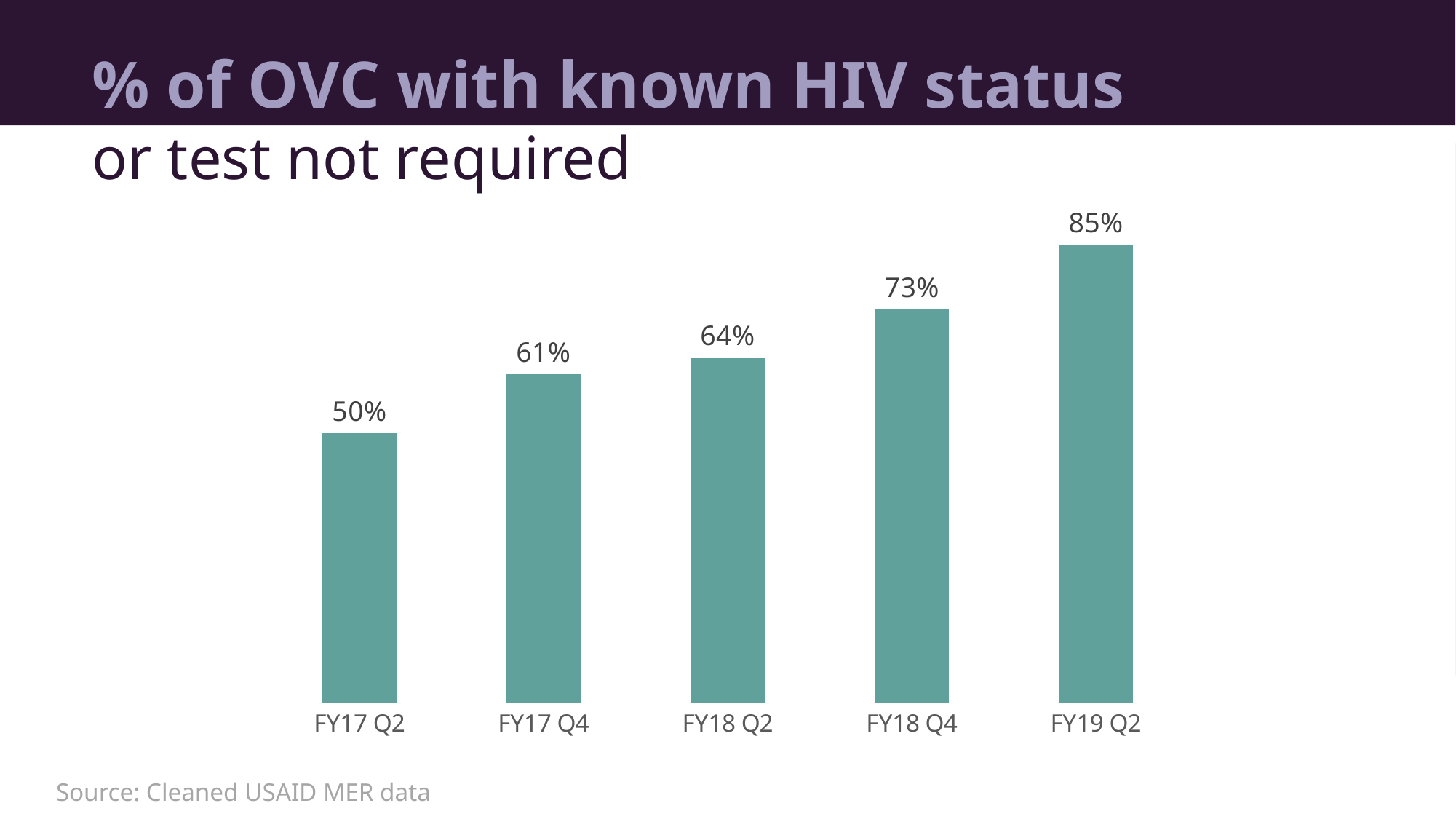
How many periods are shown on the x axis? 5 Which period has the highest value? FY19 Q2 What is the value for FY19 Q2? 85% Which period has the lowest value? FY17 Q2 What is the value for FY18 Q4? 73% What is the value for FY17 Q2? 50% What is the difference between the values for FY18 Q4 and FY18 Q2? 9% What kind of chart is shown on the slide? Bar chart What is the value for FY18 Q2? 64% Which is larger, the value for FY17 Q4 or the value for FY18 Q4? FY18 Q4 Do the values rise or fall from FY17 Q2 to FY19 Q2? Rise What is the difference between the values for FY19 Q2 and FY17 Q2? 35%